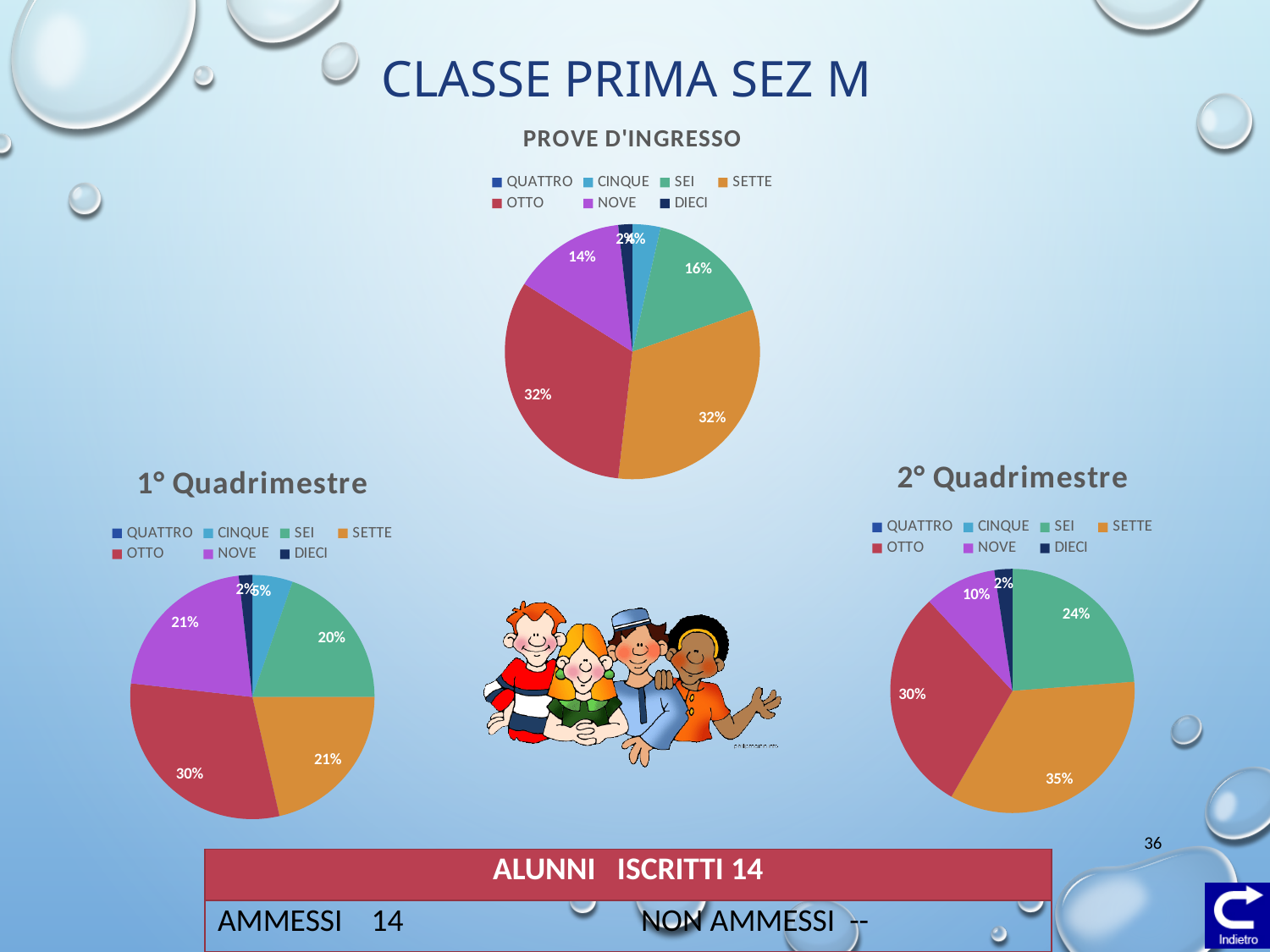
In the PROVE D'INGRESSO chart, what percentage is shown for SEI? 16% In the 1° Quadrimestre chart, what percentage is shown for OTTO? 30% In the 2° Quadrimestre chart, what percentage is shown for SETTE? 35% What kind of chart is the PROVE D'INGRESSO chart? Pie chart In the 2° Quadrimestre chart, what percentage is shown for NOVE? 10% In the PROVE D'INGRESSO chart, what percentage is shown for NOVE? 14% In the 2° Quadrimestre chart, which is larger, the slice for OTTO or the slice for SETTE? SETTE In the 2° Quadrimestre chart, what is the difference between the SETTE and OTTO percentages? 5% In the 2° Quadrimestre chart, which category has the largest slice? SETTE How many entries does the legend of the 2° Quadrimestre chart list? 7 In the 1° Quadrimestre chart, which category has the largest slice? OTTO In the 1° Quadrimestre chart, what percentage is shown for SEI? 20%